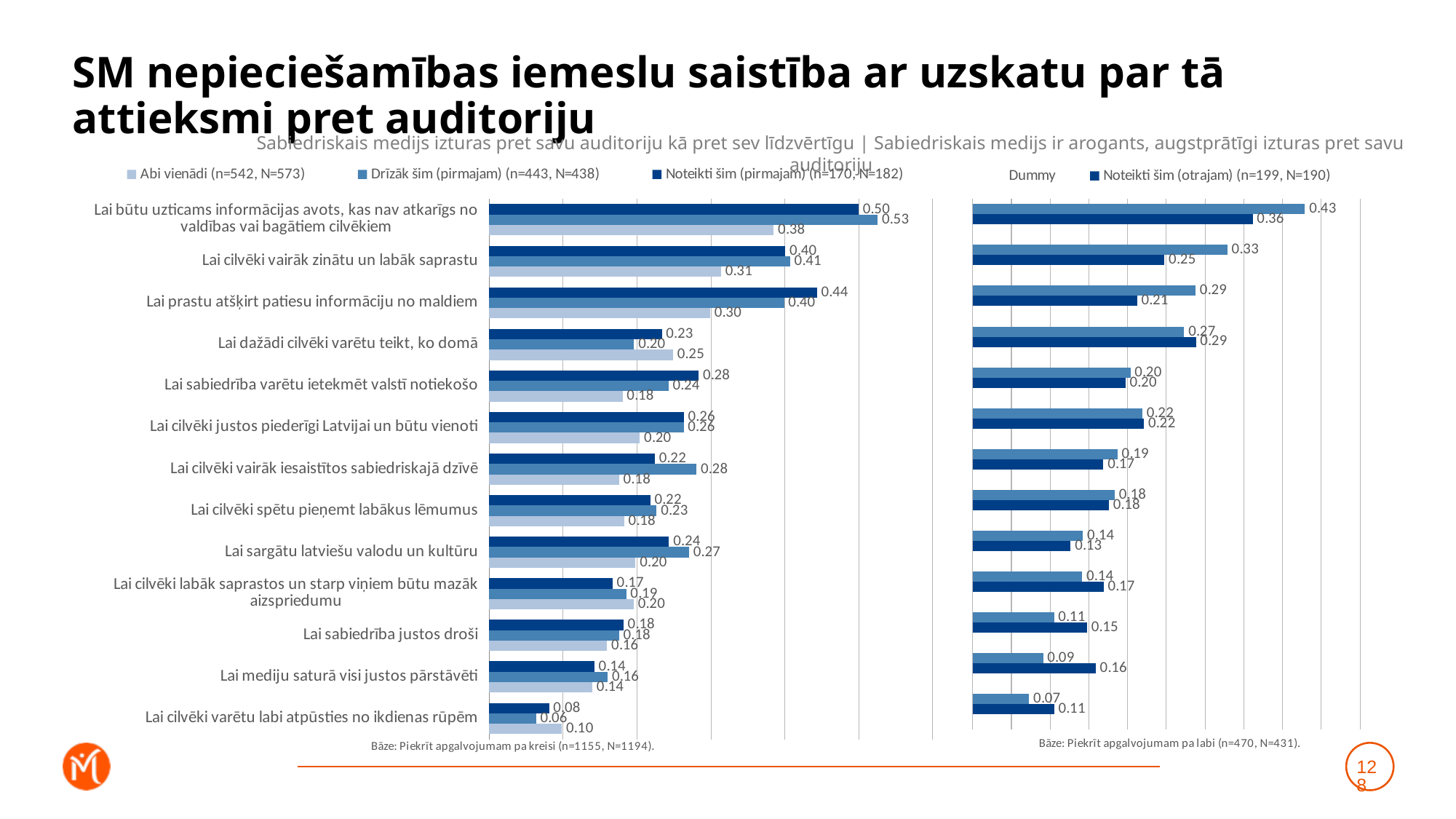
In the left chart, for "Lai cilvēki vairāk iesaistītos sabiedriskajā dzīvē", which is larger: Drīzāk šim (pirmajam) or Noteikti šim (pirmajam)? Drīzāk šim (pirmajam) What type of chart is used on this slide? Bar chart How many series does the legend of the left chart list? 3 In the left chart, which category has the highest value for Drīzāk šim (pirmajam)? Lai būtu uzticams informācijas avots, kas nav atkarīgs no valdības vai bagātiem cilvēkiem In the left chart, what is the value of Abi vienādi for "Lai prastu atšķirt patiesu informāciju no maldiem"? 0.30 In the left chart, what is the value of Noteikti šim (pirmajam) for "Lai būtu uzticams informācijas avots, kas nav atkarīgs no valdības vai bagātiem cilvēkiem"? 0.50 How many categories (statements) are listed in the left chart? 13 In the right chart, what is the value of Noteikti šim (otrajam) for "Lai cilvēki vairāk zinātu un labāk saprastu"? 0.25 In the left chart, what is the difference between Noteikti šim (pirmajam) and Abi vienādi for "Lai prastu atšķirt patiesu informāciju no maldiem"? 0.14 In the left chart, which category has the lowest value for Abi vienādi? Lai cilvēki varētu labi atpūsties no ikdienas rūpēm In the right chart, what is the value of Noteikti šim (otrajam) for "Lai mediju saturā visi justos pārstāvēti"? 0.16 In the right chart, which category has the highest value for Noteikti šim (otrajam)? Lai būtu uzticams informācijas avots, kas nav atkarīgs no valdības vai bagātiem cilvēkiem